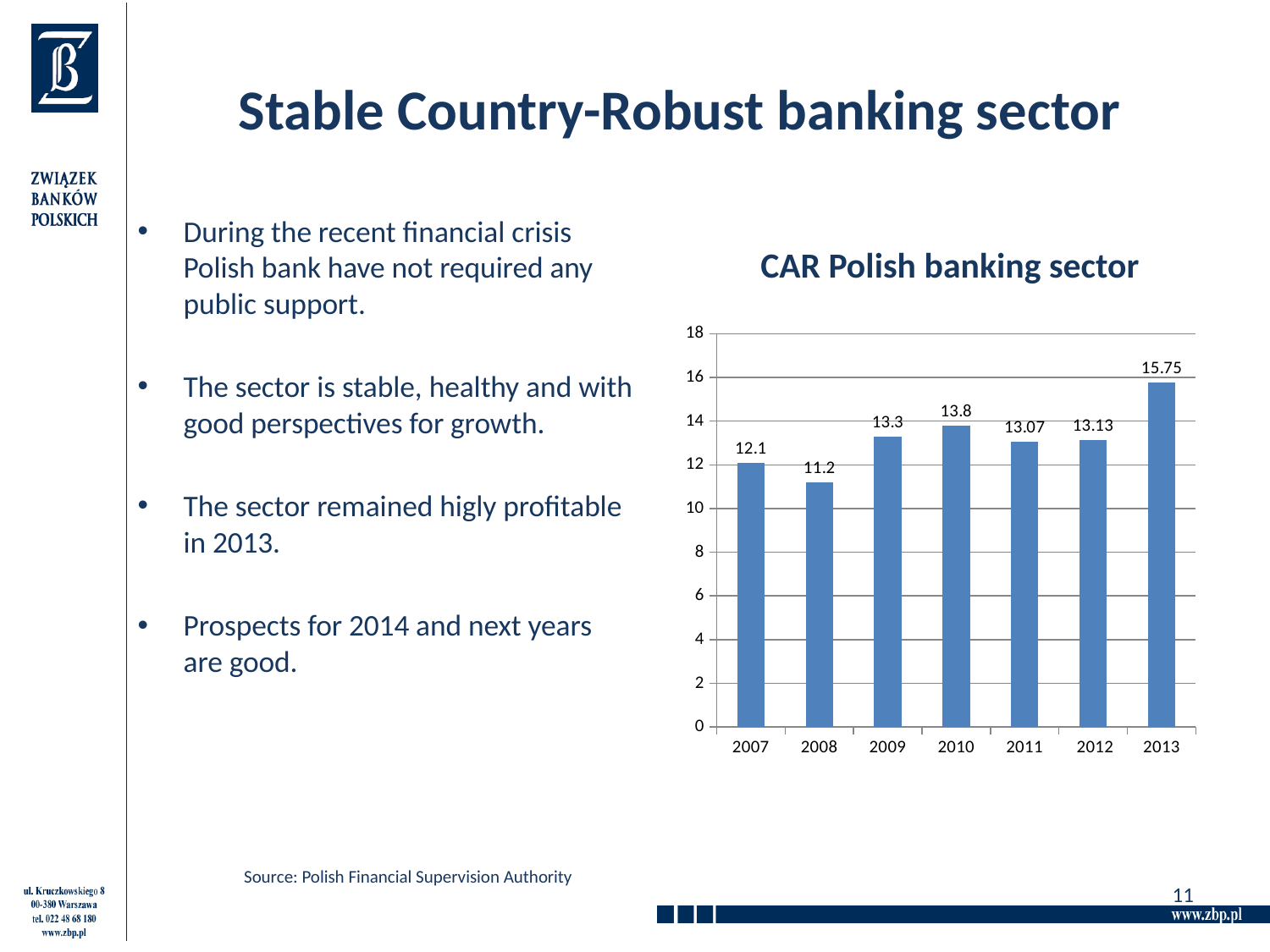
What is the CAR value for 2008? 11.2 What kind of chart is shown on the slide? bar chart What is the CAR value for 2013? 15.75 How many years are shown on the x axis of the chart? 7 What is the difference between the CAR values for 2013 and 2012? 2.62 Which year has a larger CAR value, 2007 or 2010? 2010 Which year has the lowest CAR value? 2008 What is the difference between the CAR values for 2010 and 2009? 0.5 Which year has the highest CAR value? 2013 What is the title of the chart? CAR Polish banking sector Is the CAR value for 2013 greater or less than 14? greater What is the CAR value for 2011? 13.07